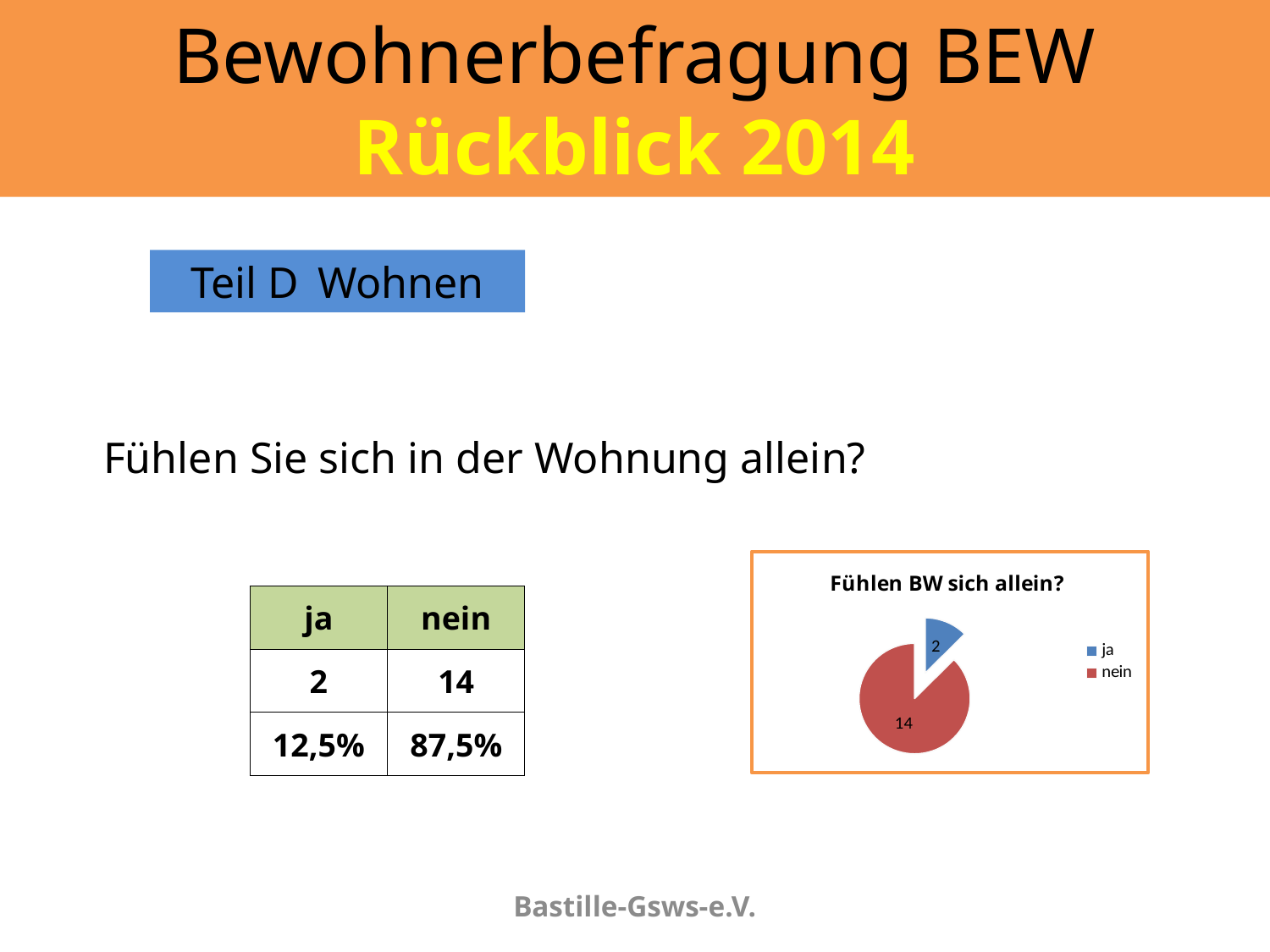
What kind of chart is shown on the slide? pie chart How many entries does the legend list? 2 What is the title of the chart? Fühlen BW sich allein? What colour is the "ja" slice in the pie chart? blue Which is larger, the value for "ja" or the value for "nein"? nein How many slices does the pie chart have? 2 What is the value for "ja" in the chart? 2 What is the value for "nein" in the chart? 14 Which slice of the pie is the smallest? ja What share of the pie does the "nein" slice represent? 87,5% Which slice of the pie is the largest? nein What is the difference between the values for "nein" and "ja"? 12